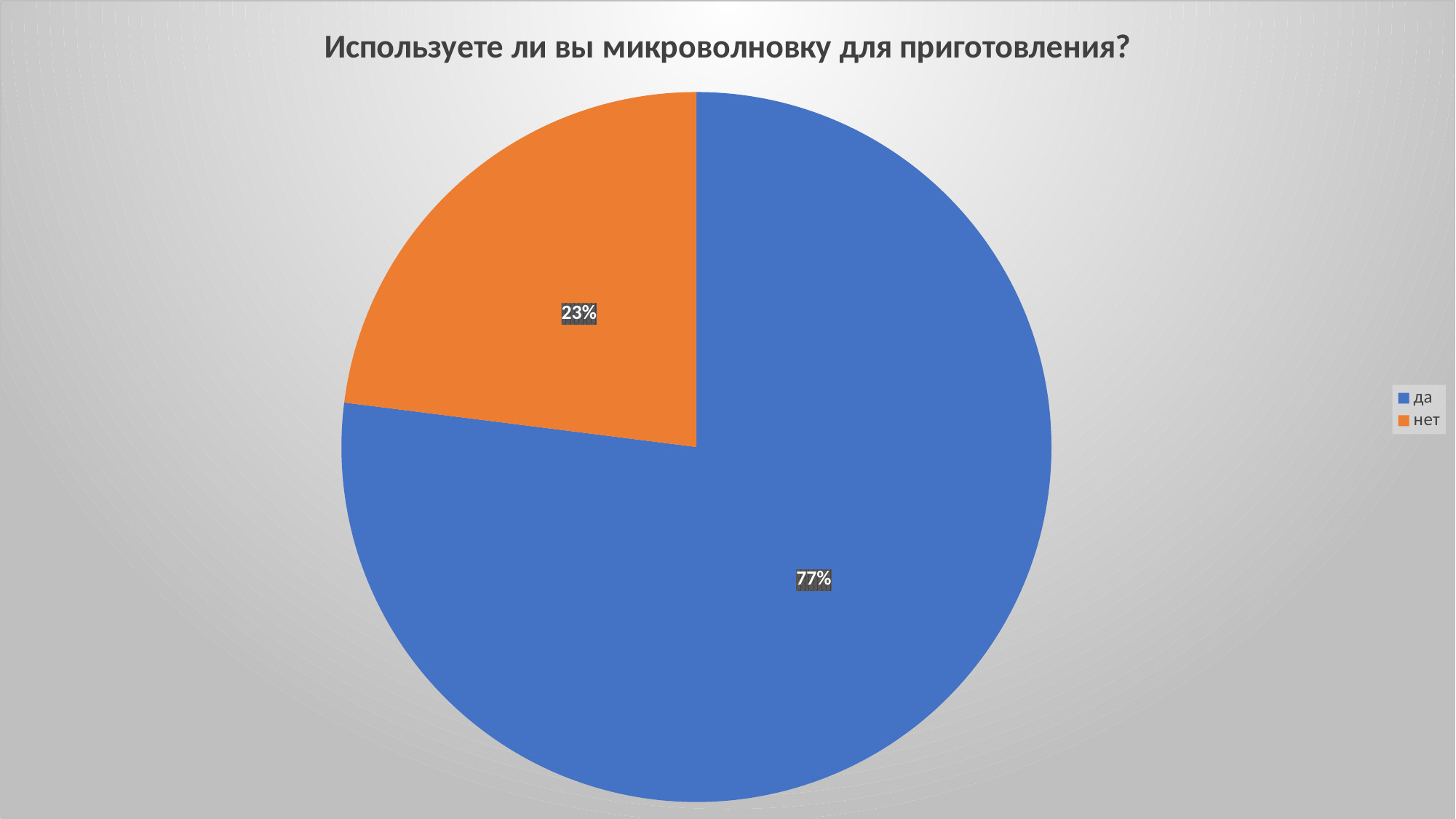
Which category has the smallest slice? нет What is the difference in percentage points between the "да" and "нет" slices? 54 How many categories does the pie chart have? 2 What is the title of the chart? Используете ли вы микроволновку для приготовления? Which category has the largest slice? да What colour is the "нет" slice? orange What kind of chart is shown on the slide? pie chart What share of the pie does the "да" slice represent? 77% How many entries does the legend list? 2 What share of the pie does the "нет" slice represent? 23% Which is larger, the "да" slice or the "нет" slice? да